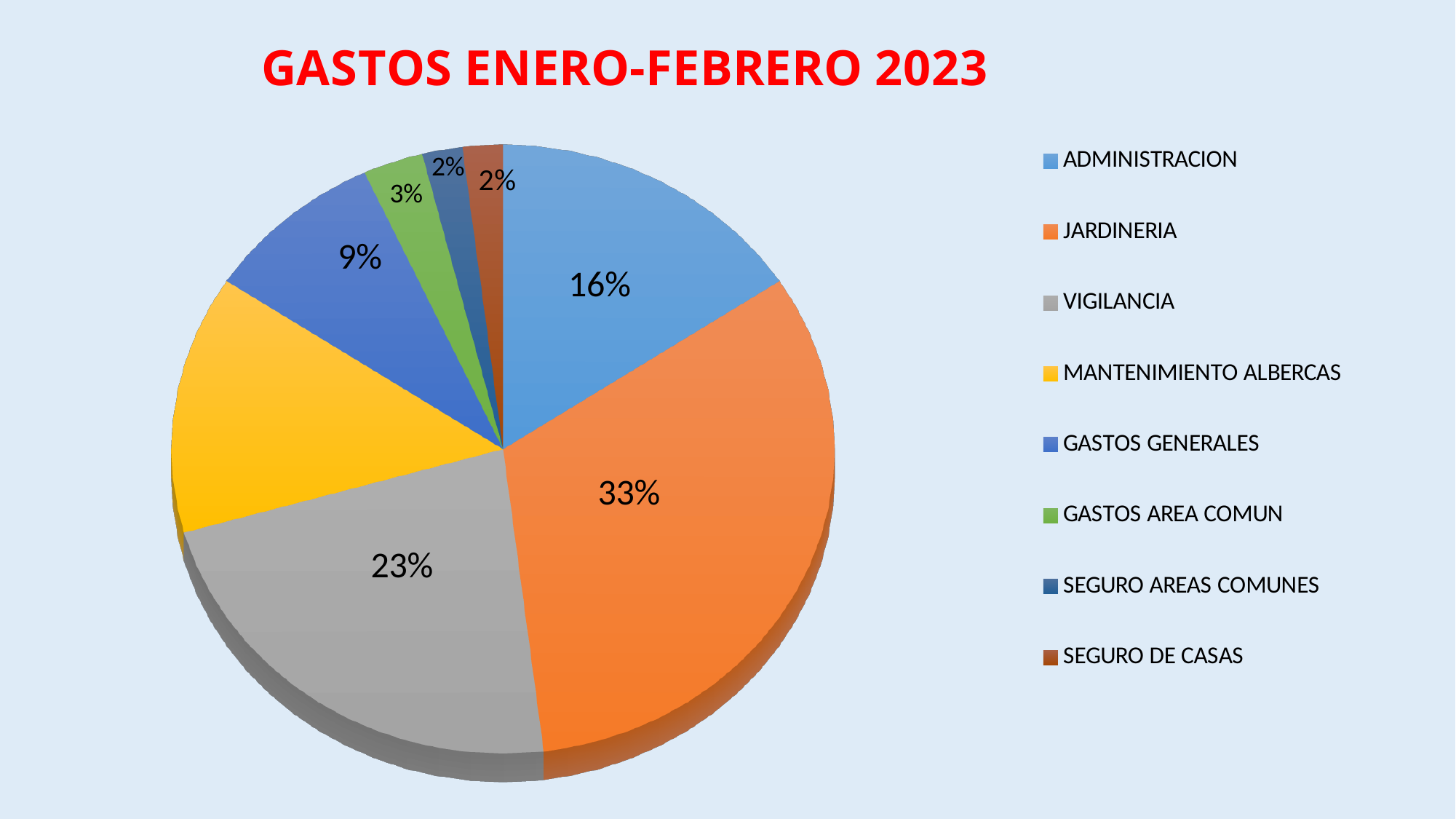
Which colour represents MANTENIMIENTO ALBERCAS in the legend? Yellow What share of the pie does JARDINERIA represent? 33% Which is larger, the share for ADMINISTRACION or the share for GASTOS GENERALES? ADMINISTRACION What percentage is shown for GASTOS GENERALES? 9% What kind of chart is shown on the slide? Pie chart What percentage is shown for ADMINISTRACION? 16% How many categories does the legend list? 8 Which category has the largest share of the pie? JARDINERIA What percentage is shown for GASTOS AREA COMUN? 3% What percentage is shown for VIGILANCIA? 23% What is the difference in percentage points between JARDINERIA and VIGILANCIA? 10 What is the title of the chart? GASTOS ENERO-FEBRERO 2023